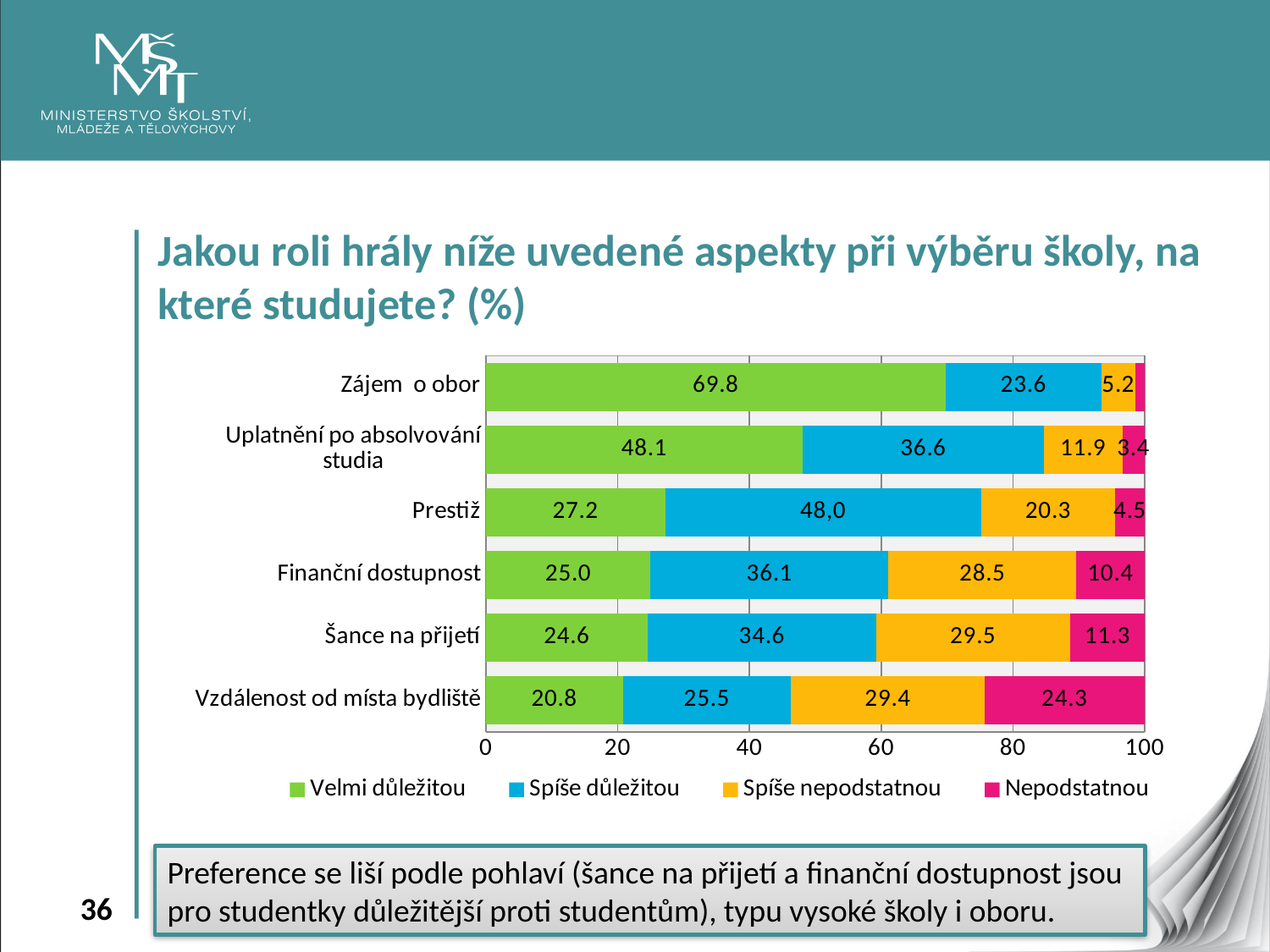
Which category has the lowest 'Velmi důležitou' value? Vzdálenost od místa bydliště What kind of chart is shown on the slide? Stacked bar chart What is the 'Velmi důležitou' value for 'Zájem o obor'? 69.8 How many series does the legend list? 4 What is the total of the stacked bar for 'Finanční dostupnost'? 100.0 What is the difference between the 'Velmi důležitou' values for 'Zájem o obor' and 'Uplatnění po absolvování studia'? 21.7 Which legend entry is shown in pink? Nepodstatnou What is the 'Spíše důležitou' value for 'Prestiž'? 48,0 Which is larger: the 'Spíše nepodstatnou' value for 'Finanční dostupnost' or for 'Šance na přijetí'? Šance na přijetí Which category has the highest 'Velmi důležitou' value? Zájem o obor How many categories (aspects) are shown on the chart? 6 What is the 'Nepodstatnou' value for 'Vzdálenost od místa bydliště'? 24.3